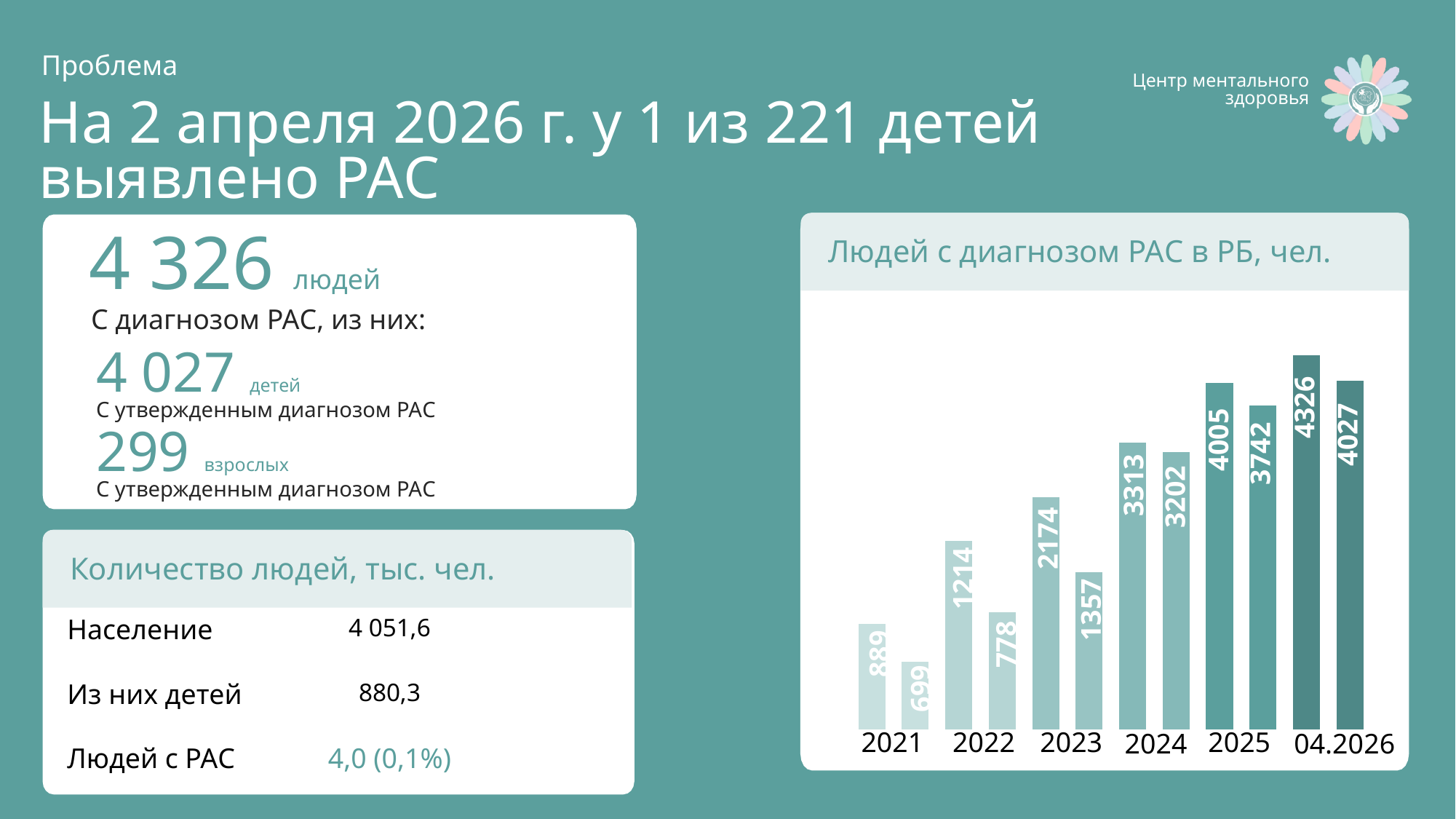
What is the value of the right (second) bar for 2025 in the chart? 3742 Which is larger in the chart: the left bar for 2022 or the right bar for 2023? the right bar for 2023 (1357) What is the value of the left (first) bar for 2021 in the chart? 889 What type of chart is shown on the slide? bar chart Which year category has the highest left (first) bar in the chart? 04.2026 What is the value of the left (first) bar for 04.2026 in the chart? 4326 What is the title of the chart on the slide? Людей с диагнозом РАС в РБ, чел. Which year category has the lowest right (second) bar in the chart? 2021 How many year categories are shown on the x axis of the chart? 6 Do the values of the left (first) bars rise or fall from 2021 to 04.2026 in the chart? rise What is the difference between the left bar for 2024 (3313) and the left bar for 2023 (2174)? 1139 What is the value of the right (second) bar for 2023 in the chart? 1357